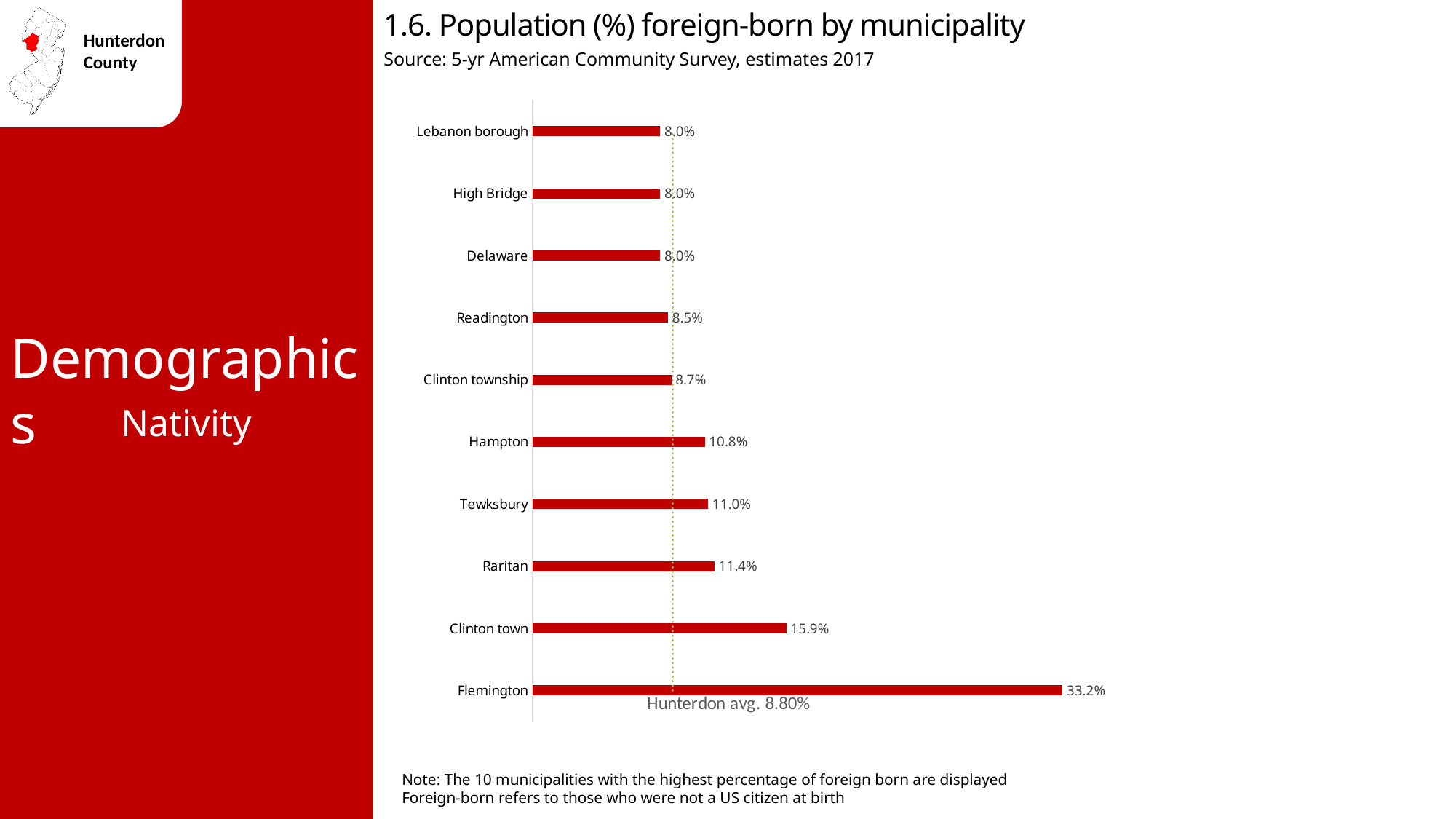
What is the source of the data shown in the chart? 5-yr American Community Survey, estimates 2017 What is the difference between the foreign-born percentages of Flemington and Clinton town? 17.3% What type of chart is used on this slide? Bar chart What is the foreign-born percentage shown for Clinton town? 15.9% What percentage of Flemington's population is foreign-born according to the chart? 33.2% Which has a higher foreign-born percentage, Raritan or Hampton? Raritan Which municipalities share the lowest value of 8.0% on the chart? Lebanon borough, High Bridge, Delaware How many municipalities are shown on the chart? 10 Which municipality has the highest foreign-born percentage on the chart? Flemington What is the Hunterdon County average foreign-born percentage marked on the chart? 8.80% What is the difference between Tewksbury's and Hampton's foreign-born percentages? 0.2% What value is shown for Readington? 8.5%